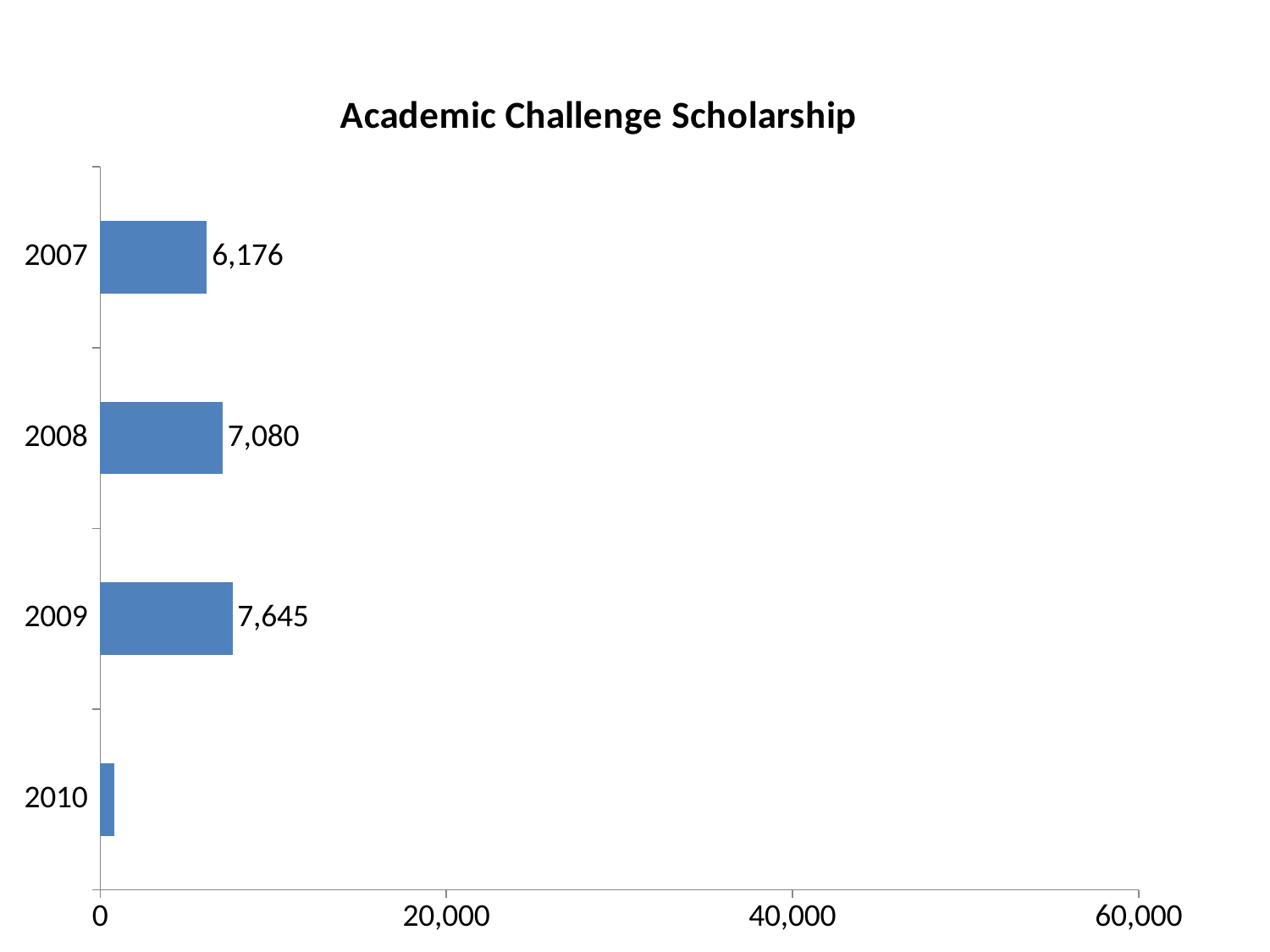
What is the value for 2007 in the Academic Challenge Scholarship chart? 6,176 Which year has the highest value in the chart? 2009 What is the difference between the values for 2009 and 2007? 1,469 What is the value for 2008 in the Academic Challenge Scholarship chart? 7,080 Which is larger, the value for 2008 or the value for 2009? 2009 What is the difference between the values for 2008 and 2007? 904 How many years are shown in the chart? 4 Is the value for 2010 greater or less than 20,000? less What kind of chart is shown on the slide? Bar chart Which year has the lowest value in the chart? 2010 What is the value for 2009 in the Academic Challenge Scholarship chart? 7,645 What is the title of the chart? Academic Challenge Scholarship